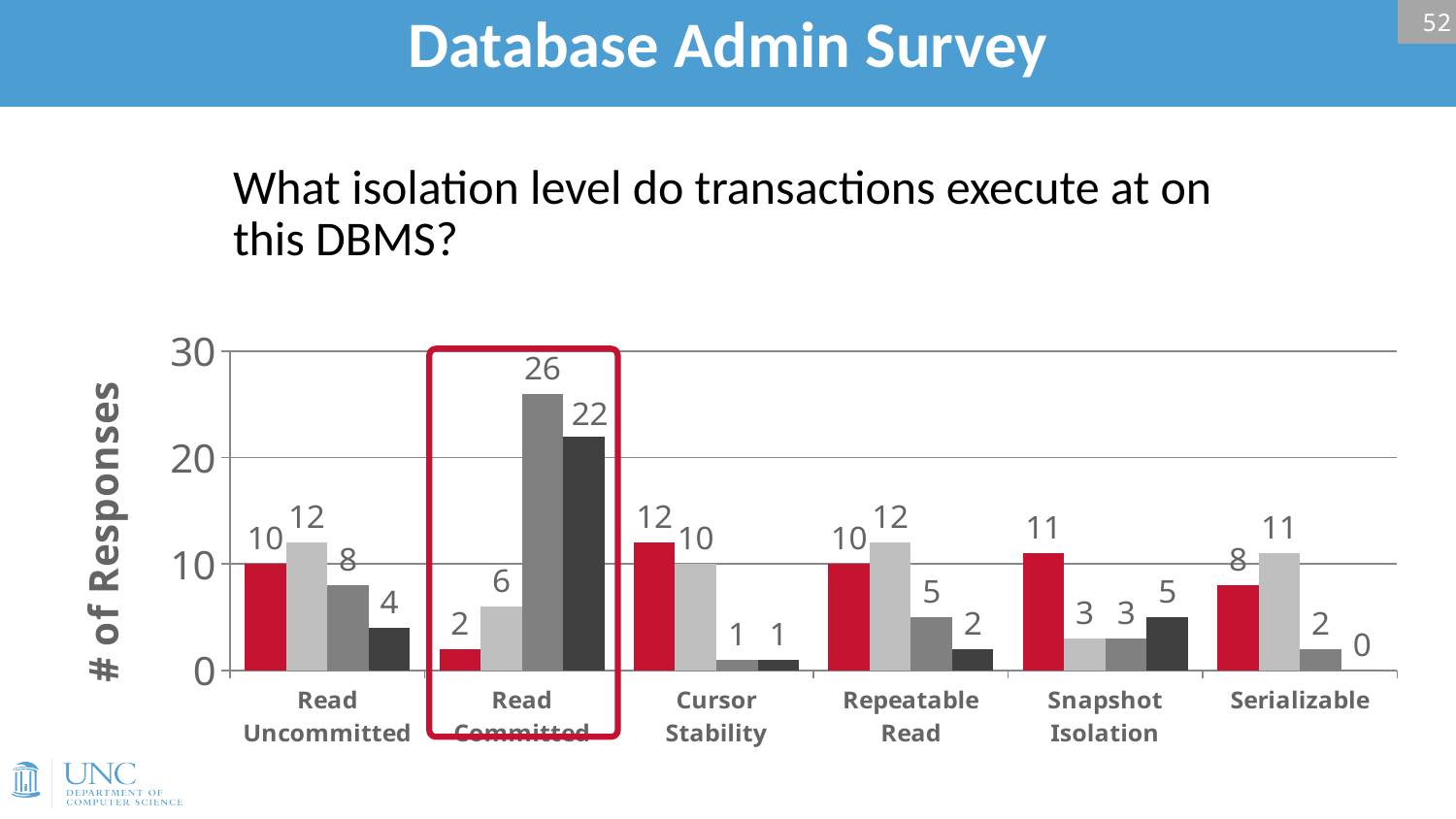
Which is larger for Cursor Stability: the red bar or the light gray bar? the red bar What is the value of the red bar for Snapshot Isolation? 11 How many isolation level categories are shown on the x axis? 6 What is the value of the dark gray bar for Serializable? 0 Which category has the highest single bar in the chart? Read Committed What is the value of the light gray bar for Read Uncommitted? 12 What is the value of the medium gray bar for Read Committed? 26 What is the label of the y axis? # of Responses Is the value of the dark gray bar for Read Committed greater or less than 20? greater What kind of chart is shown on the slide? bar chart Which category has the lowest red bar? Read Committed What is the difference between the medium gray and dark gray bars for Read Committed? 4